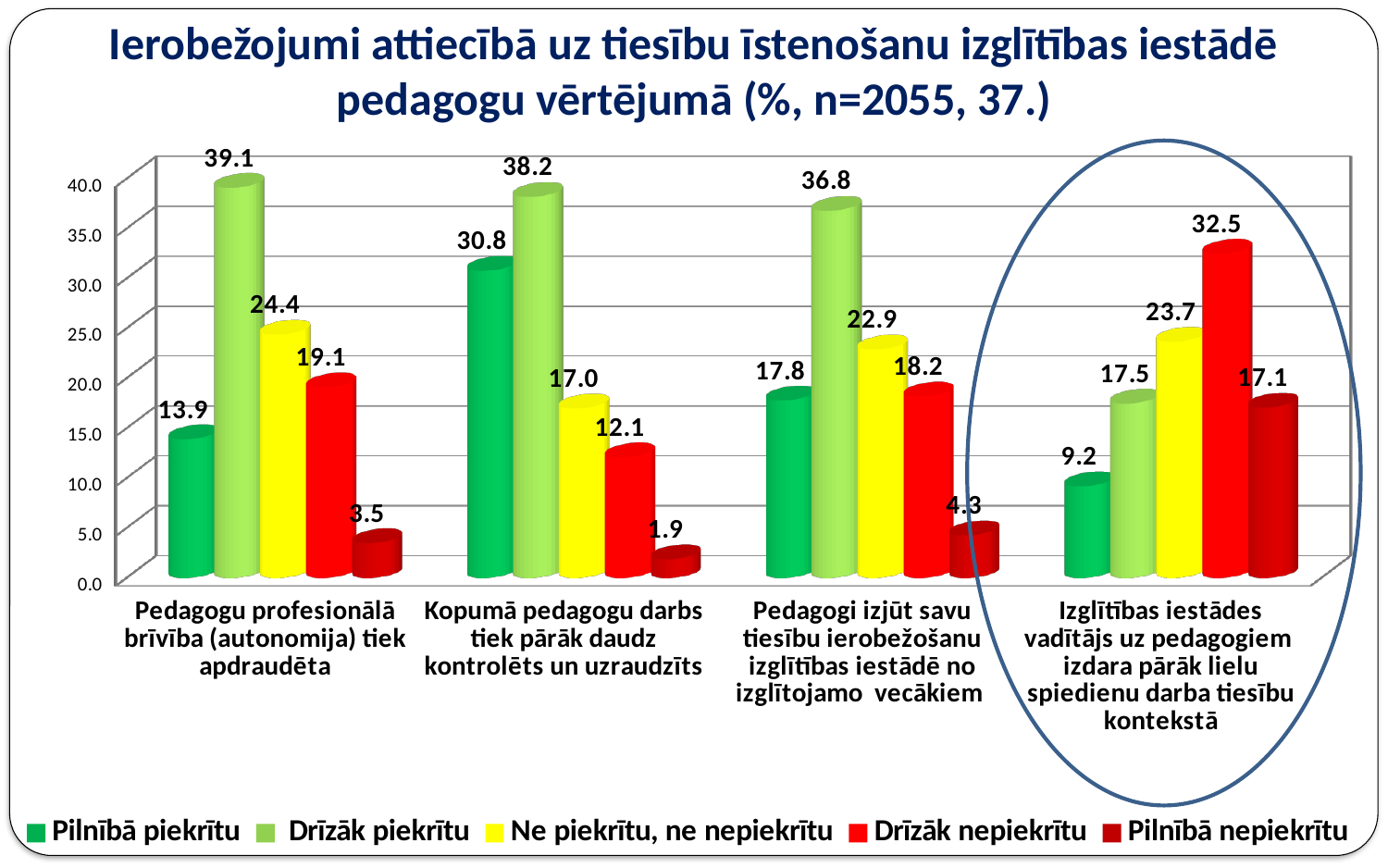
What is the value for "Pilnībā piekrītu" in the category "Kopumā pedagogu darbs tiek pārāk daudz kontrolēts un uzraudzīts"? 30.8 Which series is shown in yellow in the legend? Ne piekrītu, ne nepiekrītu What kind of chart is shown on the slide? Bar chart Which category has the lowest value for "Drīzāk piekrītu"? Izglītības iestādes vadītājs uz pedagogiem izdara pārāk lielu spiedienu darba tiesību kontekstā What is the value for "Drīzāk nepiekrītu" in the category "Izglītības iestādes vadītājs uz pedagogiem izdara pārāk lielu spiedienu darba tiesību kontekstā"? 32.5 How many categories are shown on the x axis? 4 What is the value for "Pilnībā nepiekrītu" in the category "Pedagogi izjūt savu tiesību ierobežošanu izglītības iestādē no izglītojamo vecākiem"? 4.3 How many series does the legend list? 5 In the category "Izglītības iestādes vadītājs uz pedagogiem izdara pārāk lielu spiedienu darba tiesību kontekstā", which is larger: "Ne piekrītu, ne nepiekrītu" or "Drīzāk piekrītu"? Ne piekrītu, ne nepiekrītu Which category has the highest value for "Pilnībā piekrītu"? Kopumā pedagogu darbs tiek pārāk daudz kontrolēts un uzraudzīts What is the difference between the "Drīzāk piekrītu" and "Pilnībā piekrītu" values in the category "Pedagogu profesionālā brīvība (autonomija) tiek apdraudēta"? 25.2 What is the value for "Drīzāk piekrītu" in the category "Pedagogu profesionālā brīvība (autonomija) tiek apdraudēta"? 39.1